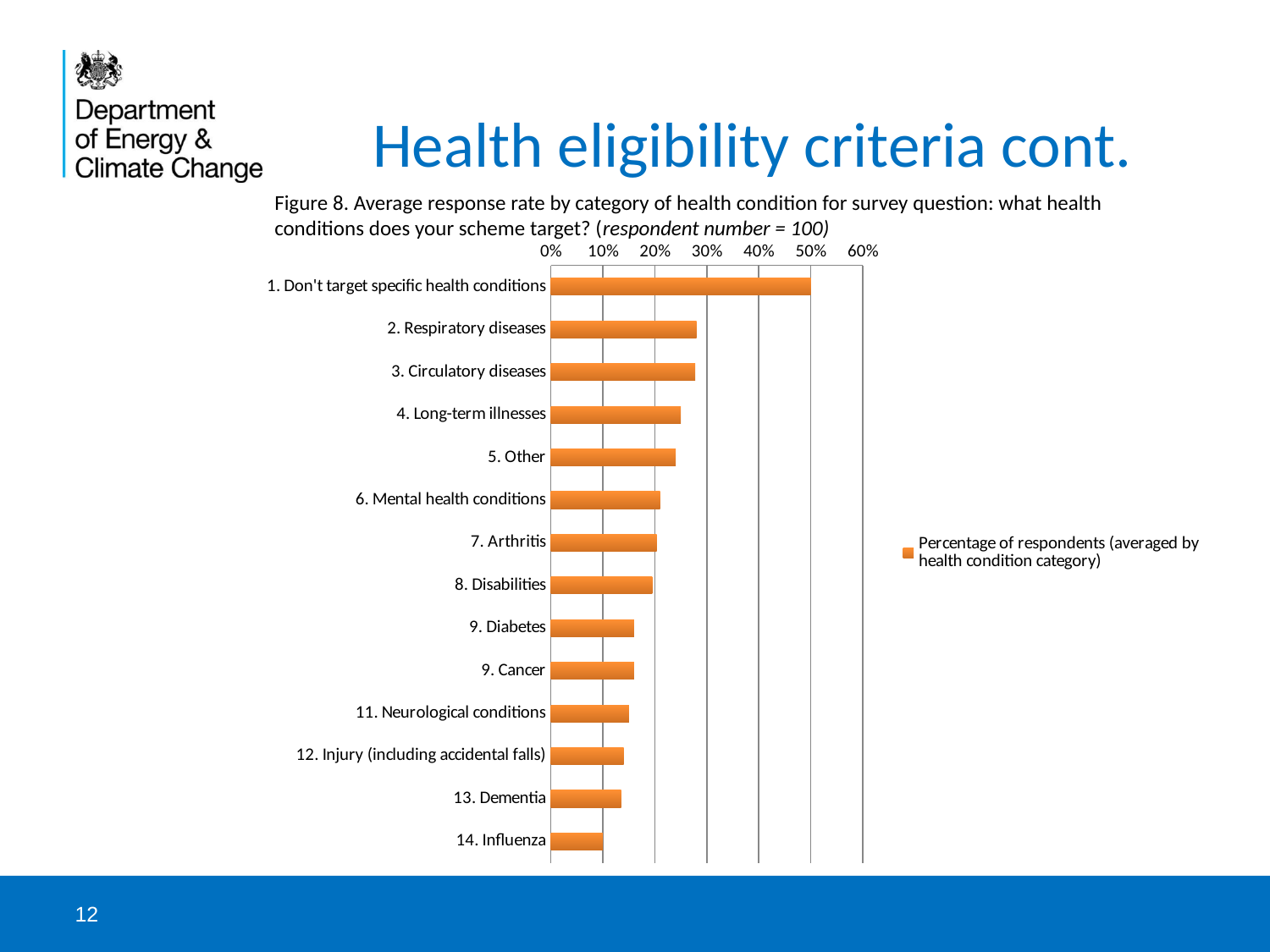
Which category has the highest percentage of respondents? 1. Don't target specific health conditions Is the value for 12. Injury (including accidental falls) greater or less than 10%? greater Which has a larger value: 4. Long-term illnesses or 13. Dementia? 4. Long-term illnesses Is the value for 1. Don't target specific health conditions greater or less than 40%? greater How many health condition categories are plotted in the chart? 14 What kind of chart is shown on the slide? Bar chart What is the figure number given in the chart's caption? Figure 8 Is the value for 3. Circulatory diseases greater or less than 30%? less How many series does the chart legend list? 1 Which category has the lowest percentage of respondents? 14. Influenza